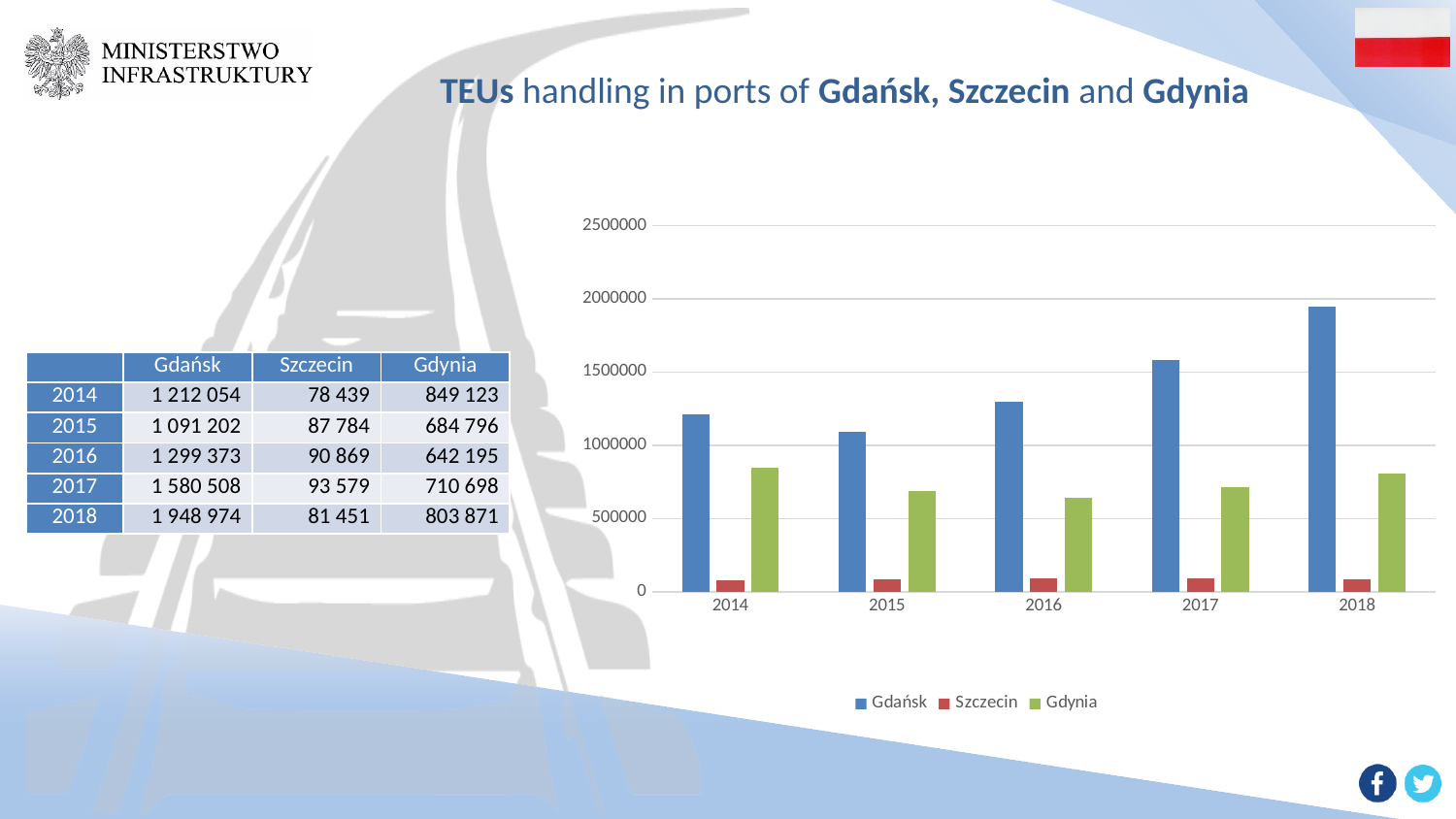
What is the difference between Gdańsk's TEU handling in 2018 and in 2017? 368 466 Which port had the highest TEU handling in 2018? Gdańsk Which port had the lowest TEU handling in every year shown? Szczecin Is the value for Gdańsk in 2017 greater or less than 1500000? greater Is the value for Gdynia in 2014 greater or less than 1000000? less What kind of chart is shown on the slide? bar chart What was the TEU handling in the port of Szczecin in 2017? 93 579 How many series does the chart legend list? 3 Which is larger: Gdynia in 2014 or Gdynia in 2018? Gdynia in 2014 How many years are shown on the x axis of the chart? 5 What was the TEU handling in the port of Gdynia in 2016? 642 195 What was the TEU handling in the port of Gdańsk in 2018? 1 948 974